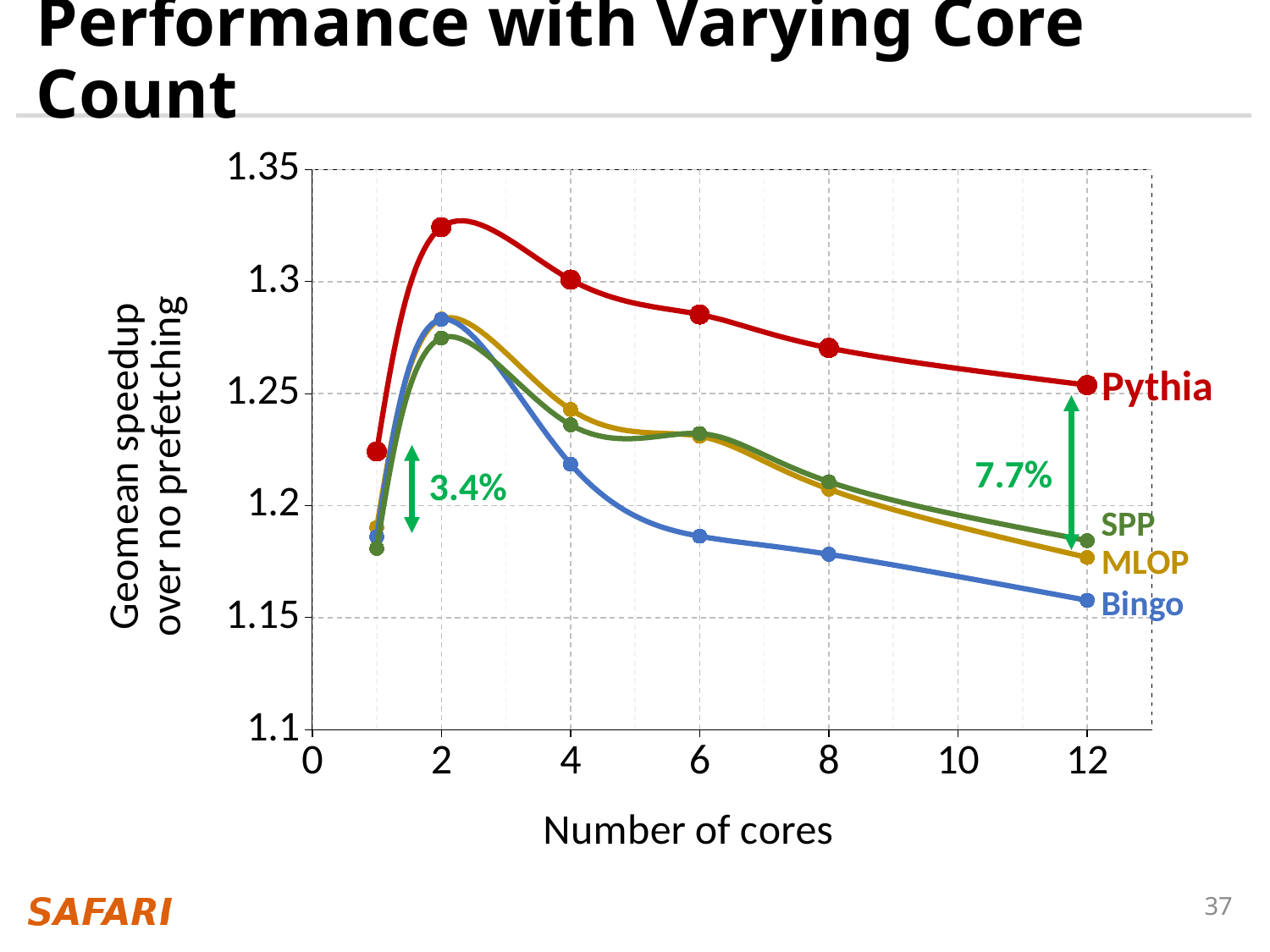
Is the geomean speedup for Pythia at 8 cores greater or less than 1.25? greater Is the geomean speedup for Bingo at 6 cores greater or less than 1.2? less Does the geomean speedup for Pythia rise or fall as the number of cores increases from 2 to 12? fall Which series has the lowest geomean speedup at 12 cores? Bingo What kind of chart is shown on the slide? line chart Which series has the highest geomean speedup at 12 cores? Pythia Is the geomean speedup for Pythia at 2 cores greater or less than 1.3? greater How many core-count data points are plotted for each series? 6 How many series (prefetchers) are plotted in the chart? 4 What percentage improvement is annotated between Pythia and the next-best prefetcher at 12 cores? 7.7% What percentage improvement is annotated at 1 core? 3.4% At which number of cores does Pythia reach its highest geomean speedup? 2